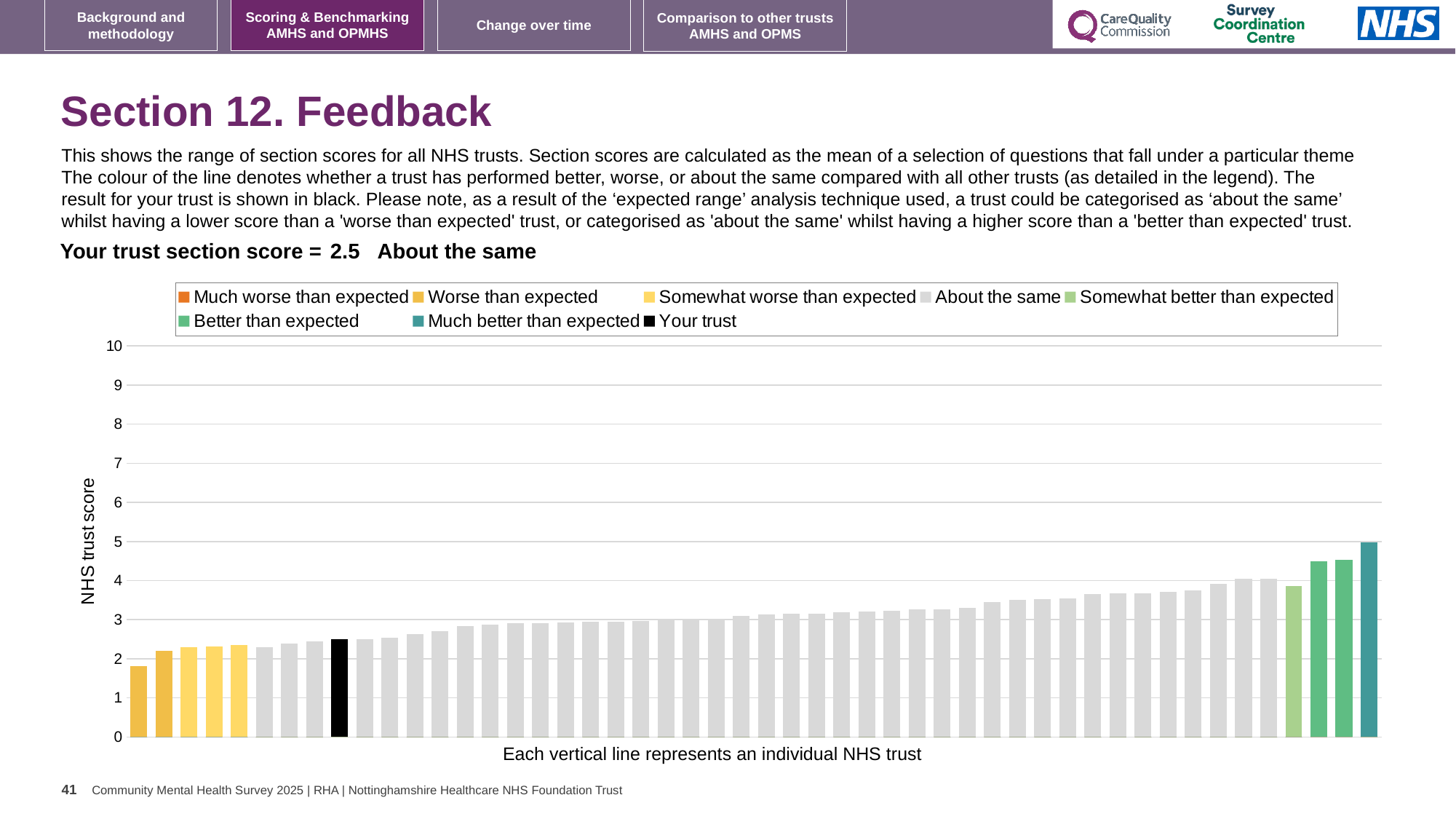
Which legend category does the tallest bar belong to? Much better than expected Is the value for the 'Your trust' bar greater or less than 2? greater What is the highest value shown on the vertical axis? 10 What is the label on the vertical axis of the chart? NHS trust score Do the bar values rise or fall from left to right along the x axis? rise Is the value for the 'Your trust' bar greater or less than 3? less What is the section score for your trust shown on the slide? 2.5 Is the value of the shortest bar greater or less than 2? less What colour is used for the 'Your trust' bar according to the legend? black How many entries does the chart legend list? 8 What kind of chart is shown on the slide? bar chart